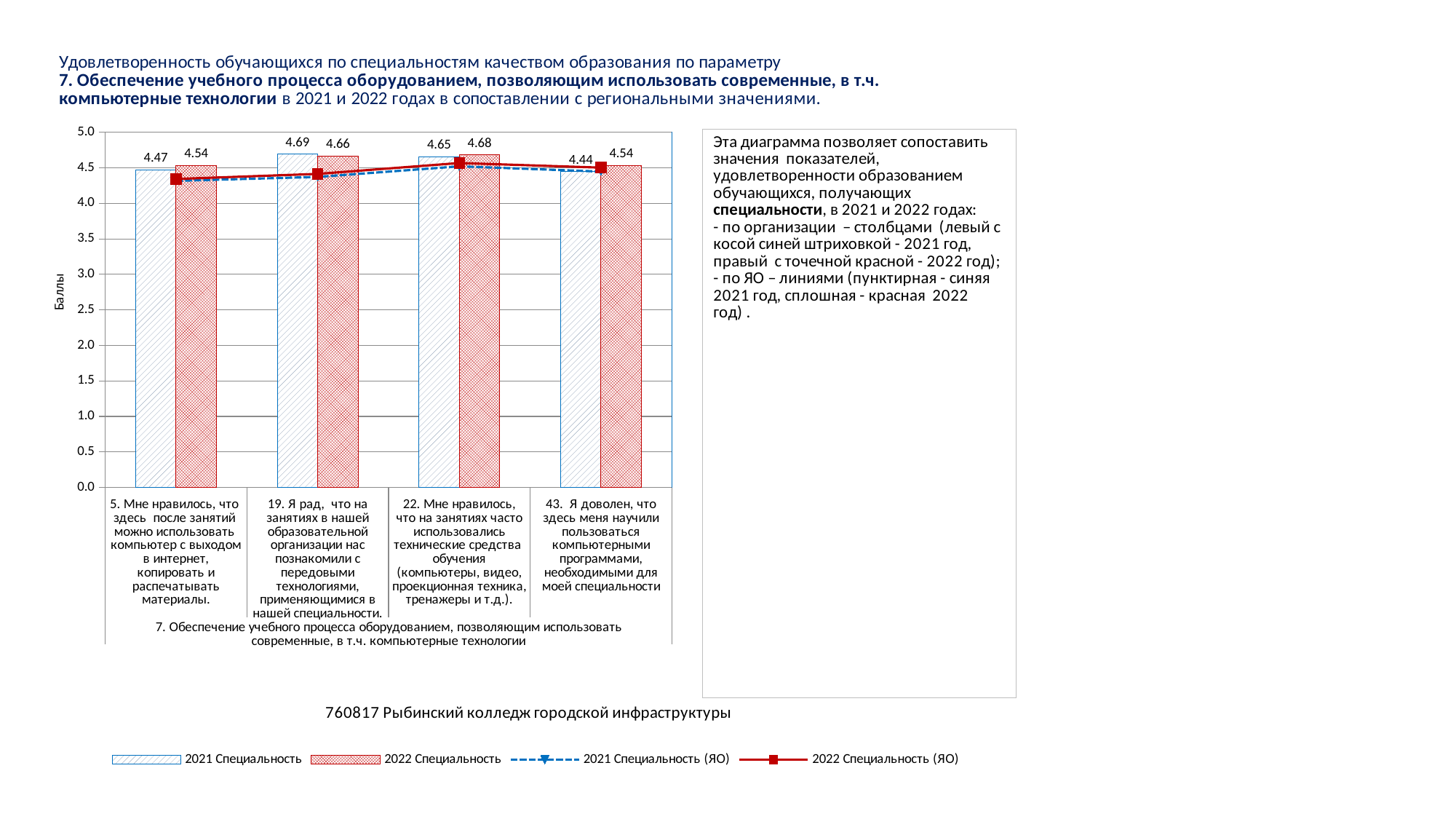
How many series does the legend list? 4 Which question has the highest 2021 Специальность value? 19. Я рад, что на занятиях в нашей образовательной организации нас познакомили с передовыми технологиями Which question has the lowest 2021 Специальность value? 43. Я доволен, что здесь меня научили пользоваться компьютерными программами What is the 2022 Специальность value for question 22 ("Мне нравилось, что на занятиях часто использовались технические средства обучения...")? 4.68 Is the 2022 Специальность (ЯО) line value for question 5 greater or less than 4.5? less What is the 2022 Специальность value for question 43 ("Я доволен, что здесь меня научили пользоваться компьютерными программами...")? 4.54 What is the difference between the 2022 and 2021 Специальность values for question 43? 0.10 How many questions (categories) are shown on the x axis? 4 What is the 2021 Специальность value for question 5 ("Мне нравилось, что здесь после занятий можно использовать компьютер с выходом в интернет...")? 4.47 What is the label of the y axis? Баллы For question 19, which is larger: the 2021 Специальность value or the 2022 Специальность value? 2021 Специальность (4.69) What kind of chart is this? Combined bar and line chart